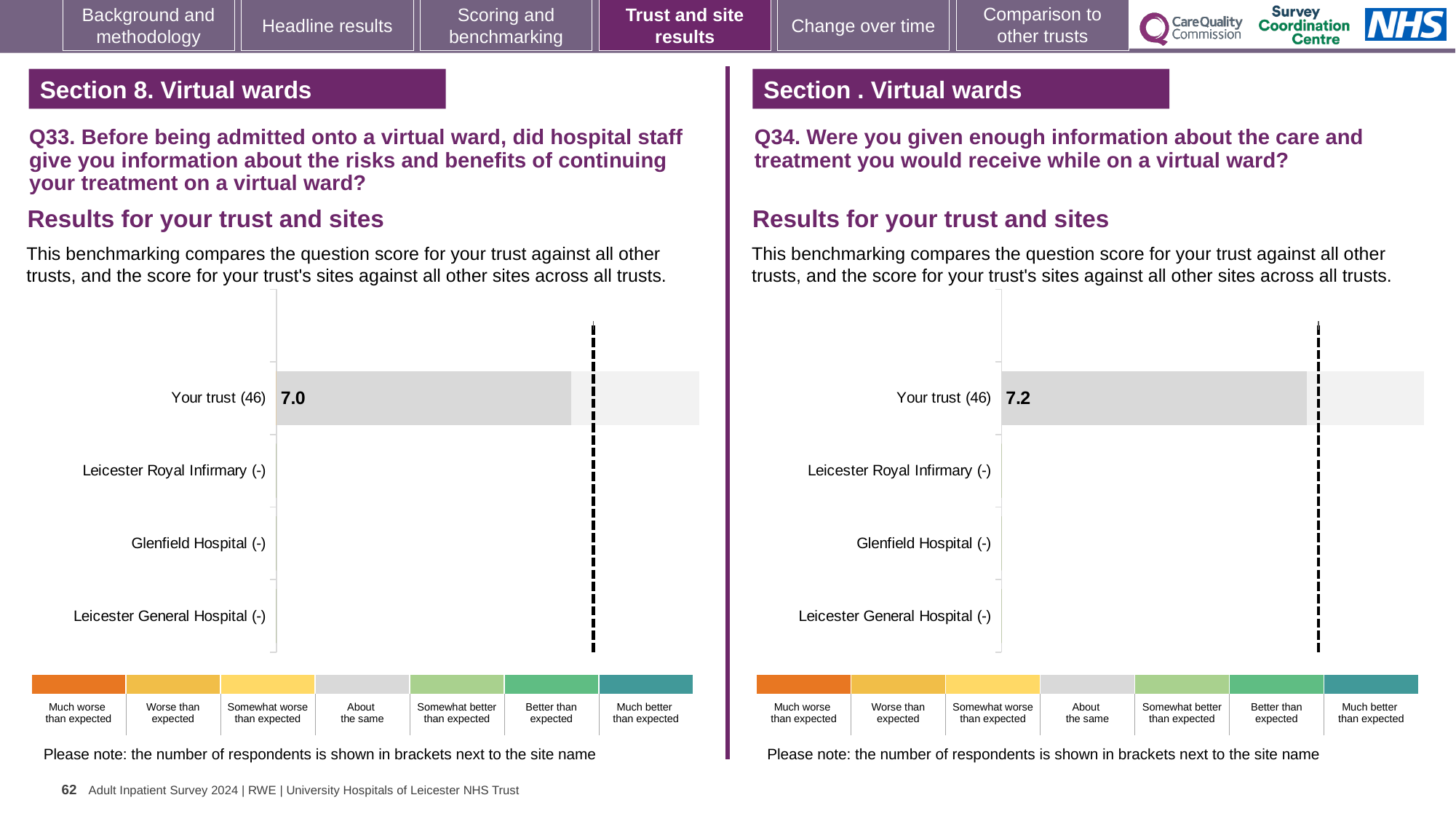
What is the difference between the Your trust score in the Q34 chart and the Your trust score in the Q33 chart? 0.2 How many benchmark bands are shown in the colour legend below the Q34 chart on the right? 7 Which chart shows a higher score for Your trust, the Q33 chart on the left or the Q34 chart on the right? Q34 chart on the right In the Q33 chart on the left, which category has the only plotted bar? Your trust (46) In the Q34 chart on the right, what is the score for Your trust? 7.2 What type of chart is used in the Q33 chart on the left? Bar chart How many categories are listed on the vertical axis of the Q34 chart on the right? 4 How many categories are listed on the vertical axis of the Q33 chart on the left? 4 In the Q33 chart on the left, how many respondents are shown in brackets next to Your trust? 46 In the Q34 chart on the right, how many respondents are shown in brackets next to Your trust? 46 In the Q34 chart on the right, which category is listed last on the vertical axis? Leicester General Hospital (-) In the Q33 chart on the left, what is the score for Your trust? 7.0